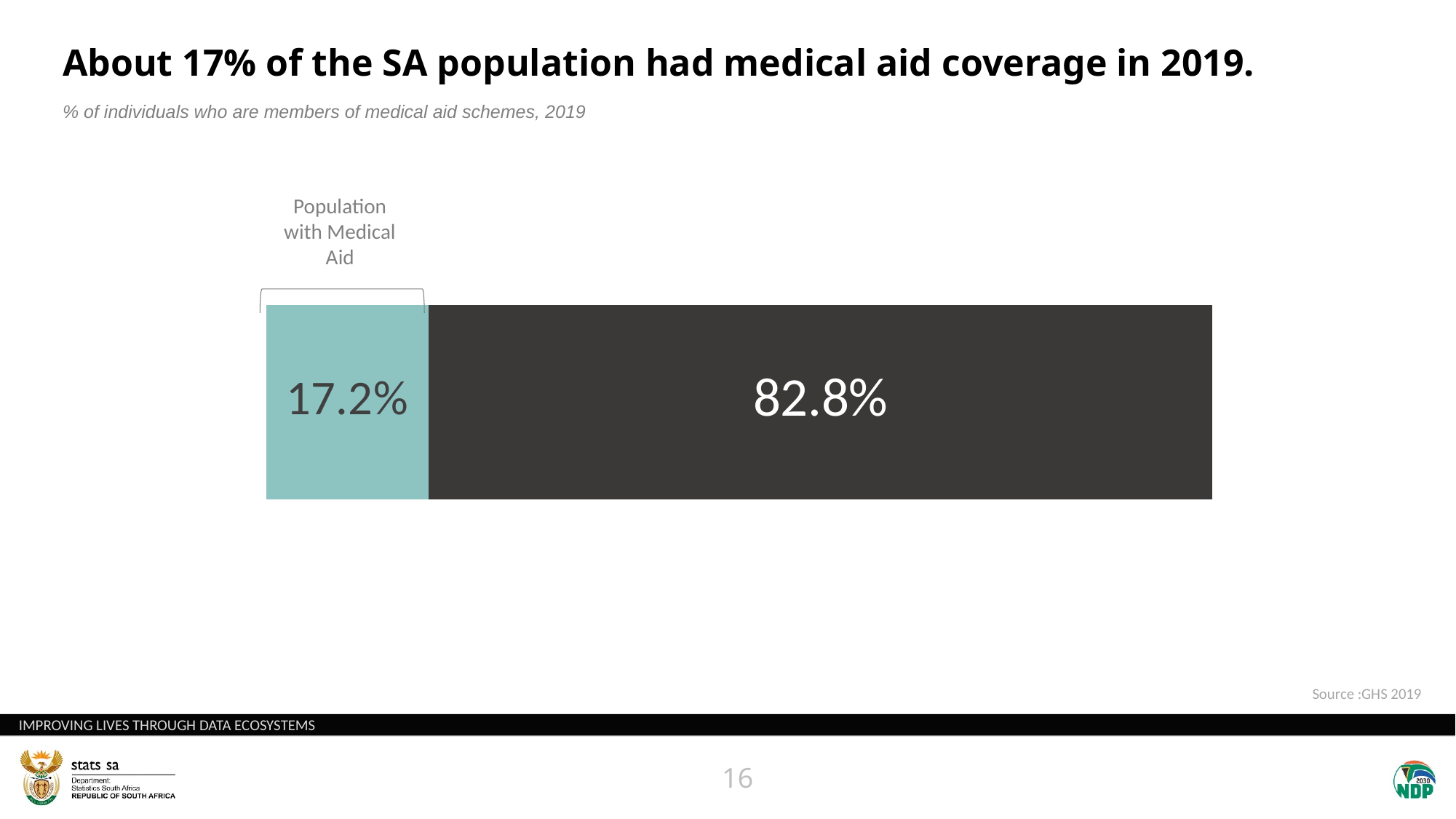
Which segment has the smallest value? Population with Medical Aid (17.2%) What percentage of the population is shown as having medical aid? 17.2% What do the two segments of the bar add up to? 100% Which segment of the bar is larger, the teal 'Population with Medical Aid' segment or the dark segment? The dark segment (82.8%) What colour is the 'Population with Medical Aid' segment? Teal How many segments does the bar have? 2 What value is printed on the dark segment of the bar? 82.8% What is the subtitle describing the chart's measure? % of individuals who are members of medical aid schemes, 2019 What is the difference between the two values shown on the bar? 65.6 percentage points What kind of chart is shown on the slide? Bar chart (stacked horizontal bar)